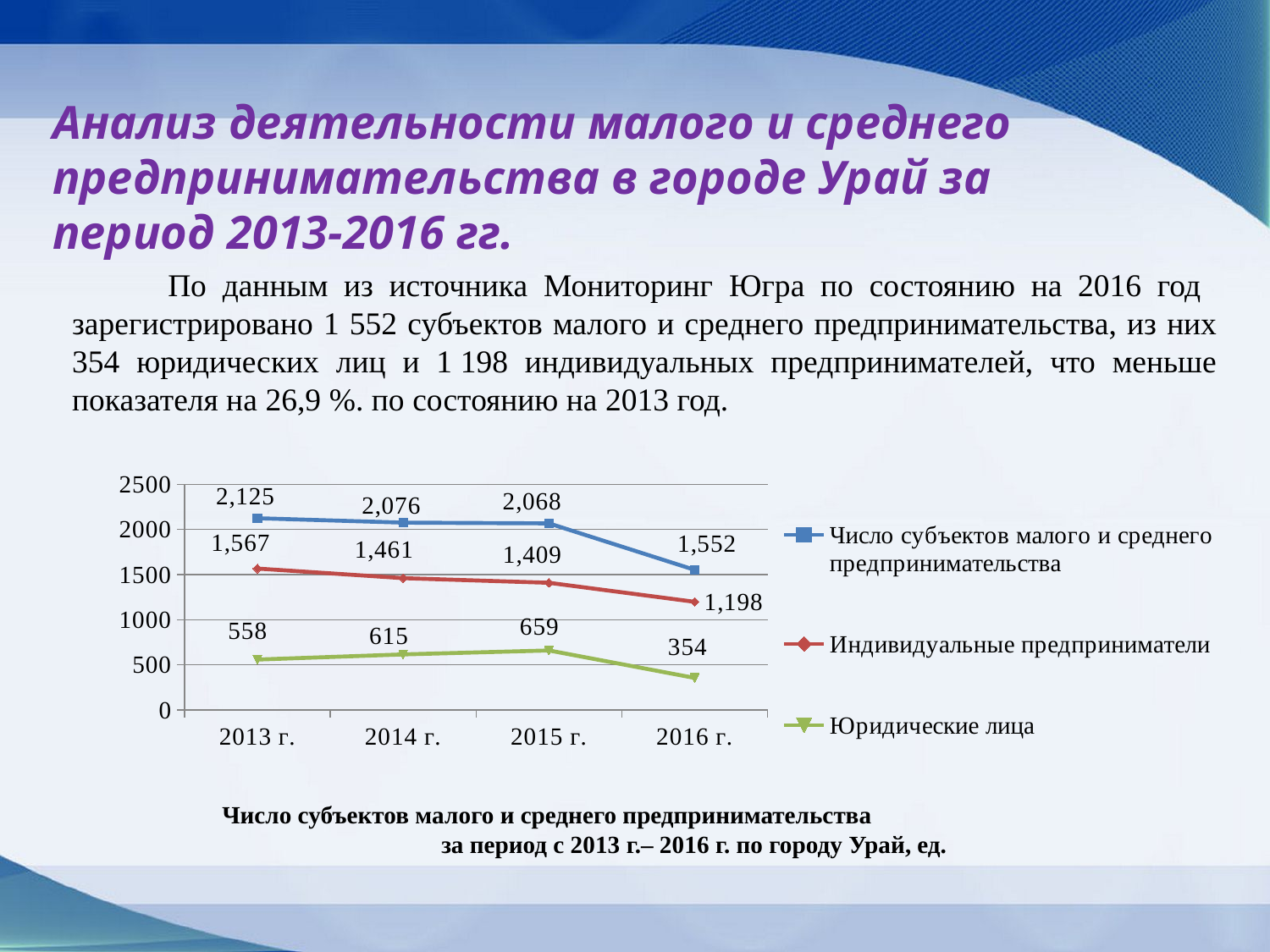
What is the difference between the "Число субъектов малого и среднего предпринимательства" values for 2015 г. and 2016 г.? 516 In which year is the value for "Число субъектов малого и среднего предпринимательства" lowest? 2016 г. Does the value for "Индивидуальные предприниматели" rise or fall from 2013 г. to 2016 г.? fall What is the value for "Юридические лица" in 2015 г.? 659 What is the value for "Число субъектов малого и среднего предпринимательства" in 2013 г.? 2,125 In which year is the value for "Юридические лица" highest? 2015 г. What kind of chart is shown on the slide? line chart How many series does the legend list? 3 How many years are shown on the x axis? 4 Is the value for "Индивидуальные предприниматели" in 2014 г. greater or less than 1500? less What is the value for "Индивидуальные предприниматели" in 2016 г.? 1,198 Which is larger: the value for "Юридические лица" in 2014 г. or in 2016 г.? 2014 г.